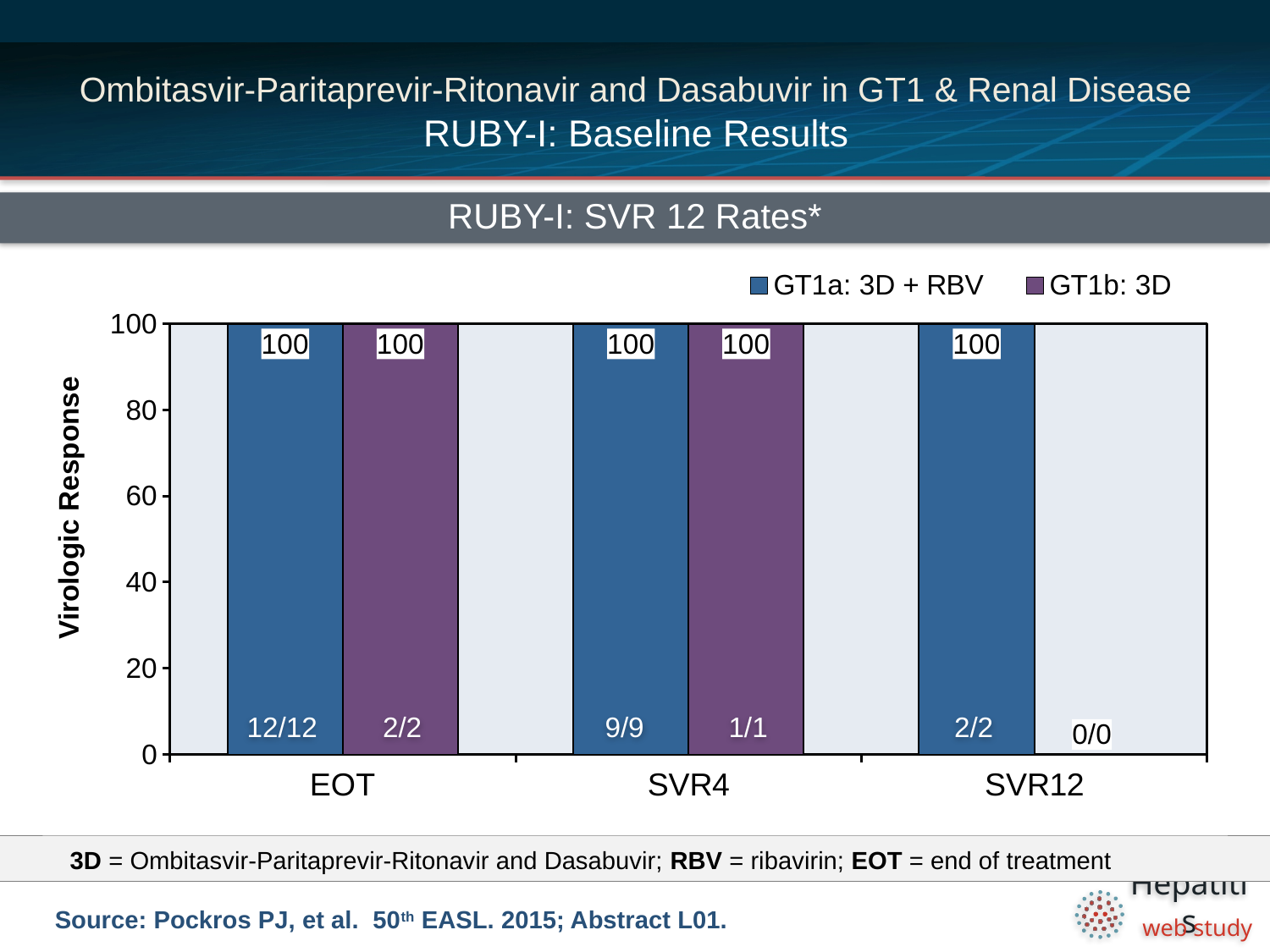
How many series does the legend list? 2 How many categories are shown on the x axis? 3 What kind of chart is shown? bar chart What is the virologic response value for GT1a: 3D + RBV at SVR12? 100 What fraction of patients is shown for GT1b: 3D at SVR12? 0/0 What is the virologic response value for GT1a: 3D + RBV at EOT? 100 What fraction of patients is shown for GT1a: 3D + RBV at SVR4? 9/9 What is the label of the y axis? Virologic Response What is the title of the chart? RUBY-I: SVR 12 Rates* What fraction of patients is shown for GT1a: 3D + RBV at EOT? 12/12 What fraction of patients is shown for GT1a: 3D + RBV at SVR12? 2/2 What is the virologic response value for GT1b: 3D at SVR4? 100